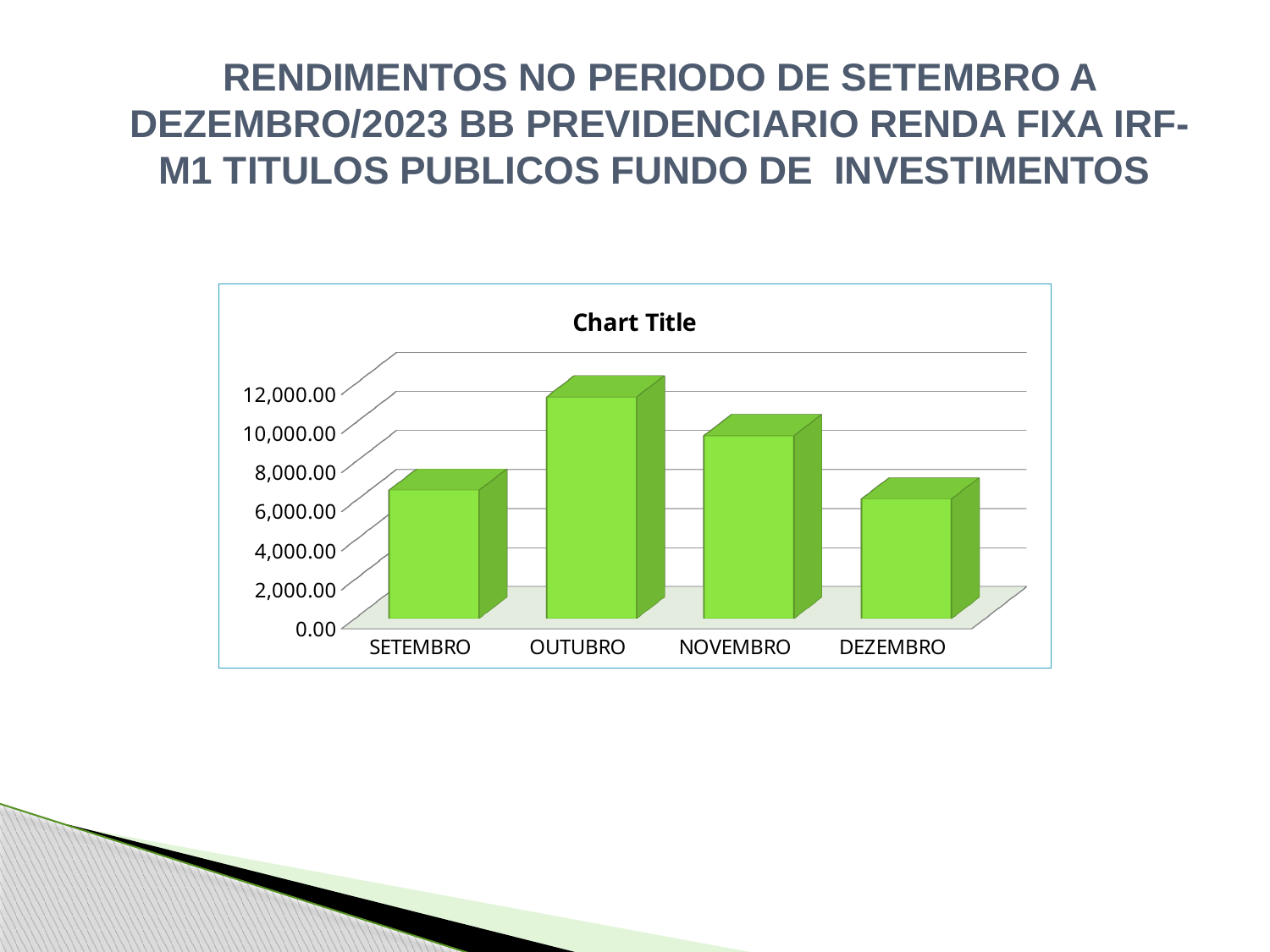
How many categories are shown on the x axis of the chart? 4 What kind of chart is shown on the slide? bar chart Which month has the highest value in the chart? OUTUBRO What is the title printed inside the chart area? Chart Title Do the values rise or fall from OUTUBRO to DEZEMBRO? fall Which is larger, the value for OUTUBRO or the value for NOVEMBRO? OUTUBRO Which is larger, the value for NOVEMBRO or the value for SETEMBRO? NOVEMBRO Is the value for SETEMBRO greater or less than 8,000.00? less Is the value for OUTUBRO greater or less than 10,000.00? greater Is the value for DEZEMBRO greater or less than 8,000.00? less